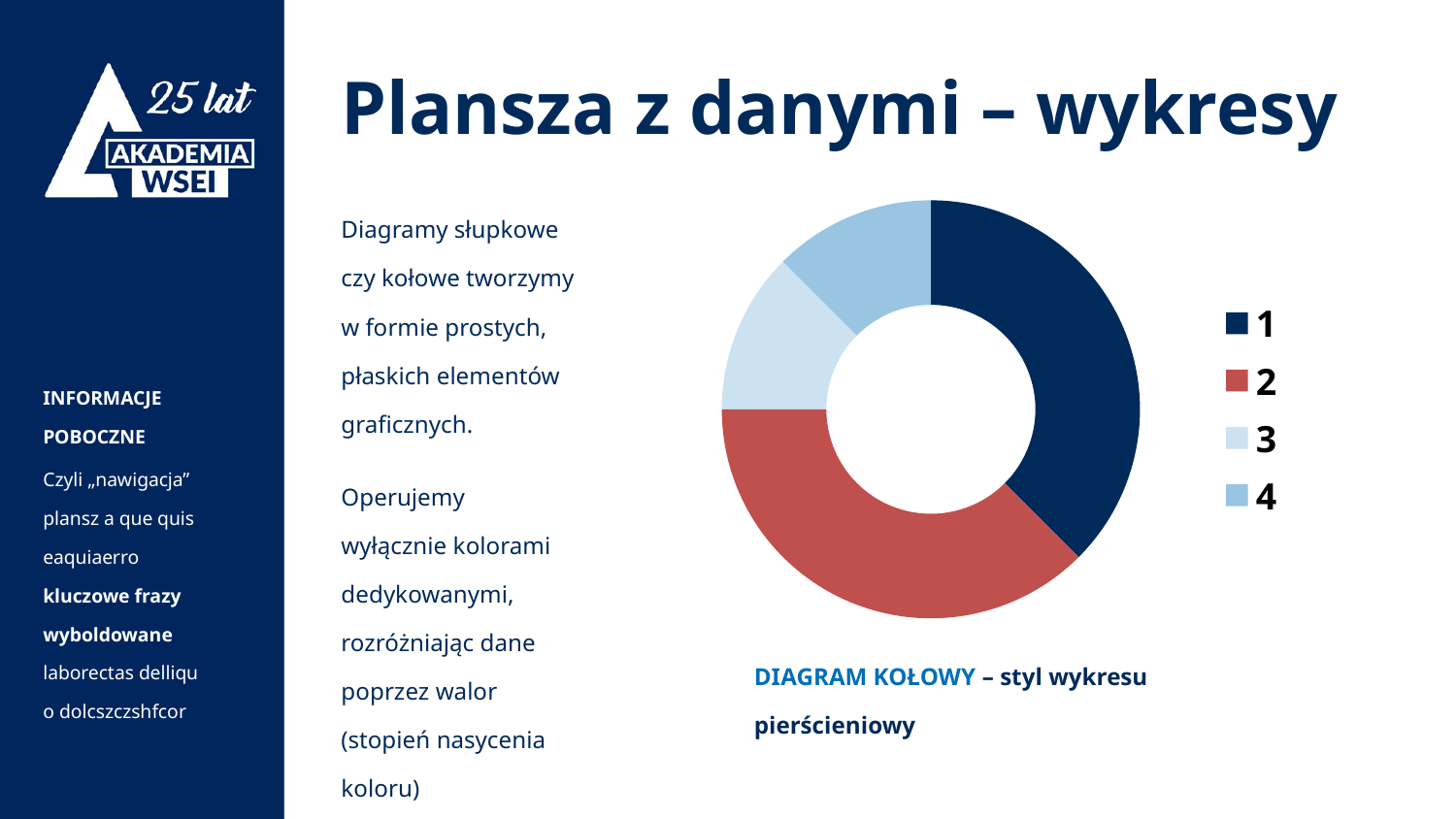
What kind of chart is shown on the slide? Doughnut (ring) chart Which is larger in the doughnut chart, the slice for category 2 or the slice for category 4? 2 What colour is the slice for category 2 in the doughnut chart? Red Which is larger in the doughnut chart, the slice for category 1 or the slice for category 3? 1 Which is larger in the doughnut chart, the slice for category 2 or the slice for category 3? 2 How many entries does the legend of the doughnut chart list? 4 How many categories does the doughnut chart show? 4 What are the legend entries of the doughnut chart? 1, 2, 3, 4